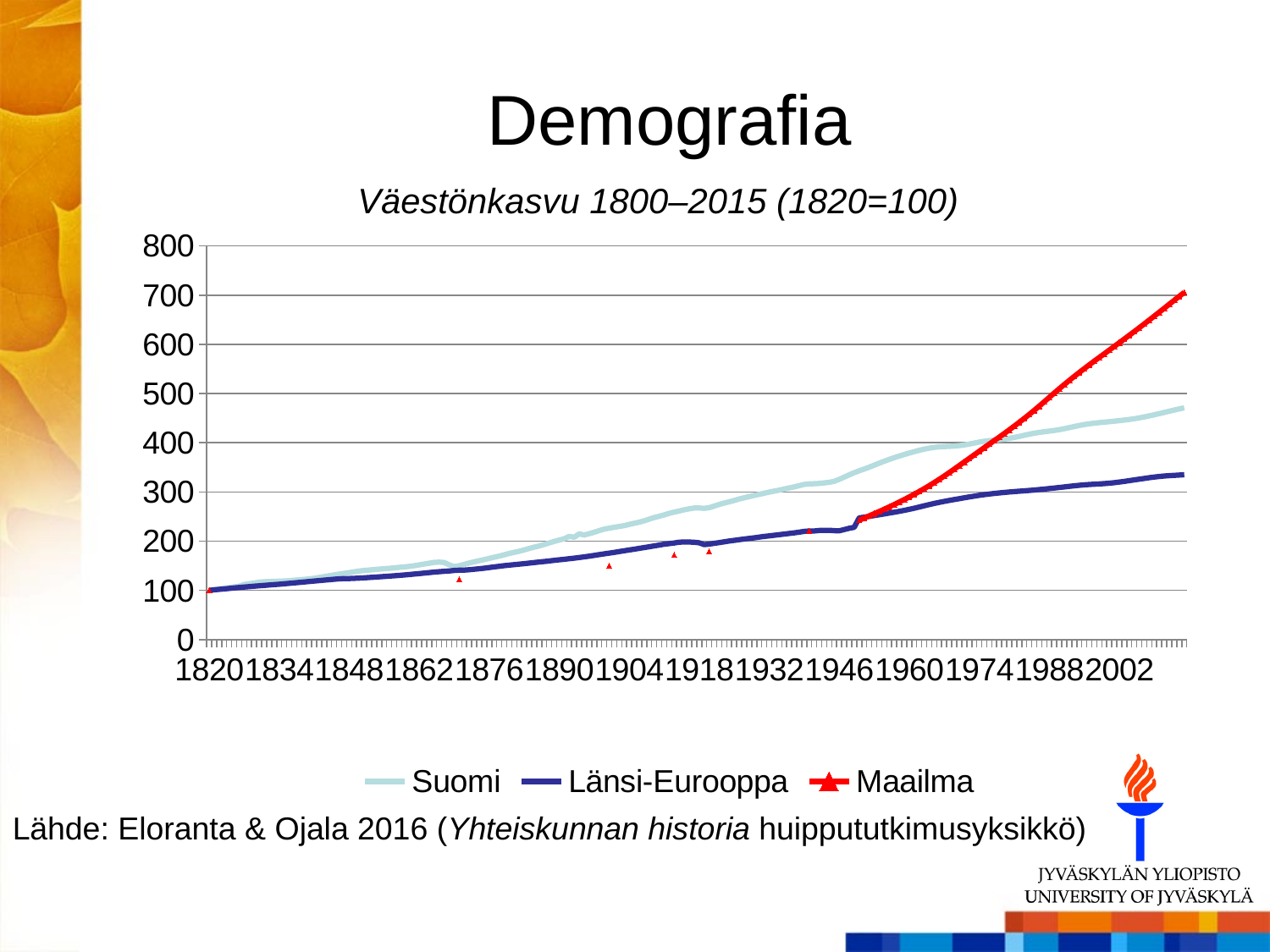
In 1960, which is larger, the value for Suomi or the value for Länsi-Eurooppa? Suomi Which series has the highest value at the right end of the chart (2015)? Maailma Which series has the lowest value at the right end of the chart (2015)? Länsi-Eurooppa How many series does the legend list? 3 What kind of chart is shown on the slide? line chart What is the title of the chart? Väestönkasvu 1800–2015 (1820=100) Is the value for Länsi-Eurooppa in 1904 greater or less than 200? less Do the values for Maailma rise or fall from 1946 to 2015? rise Is the value for Länsi-Eurooppa at the right end of the chart greater or less than 400? less Is the value for Maailma at the right end of the chart greater or less than 600? greater Which series is plotted with red triangle markers? Maailma